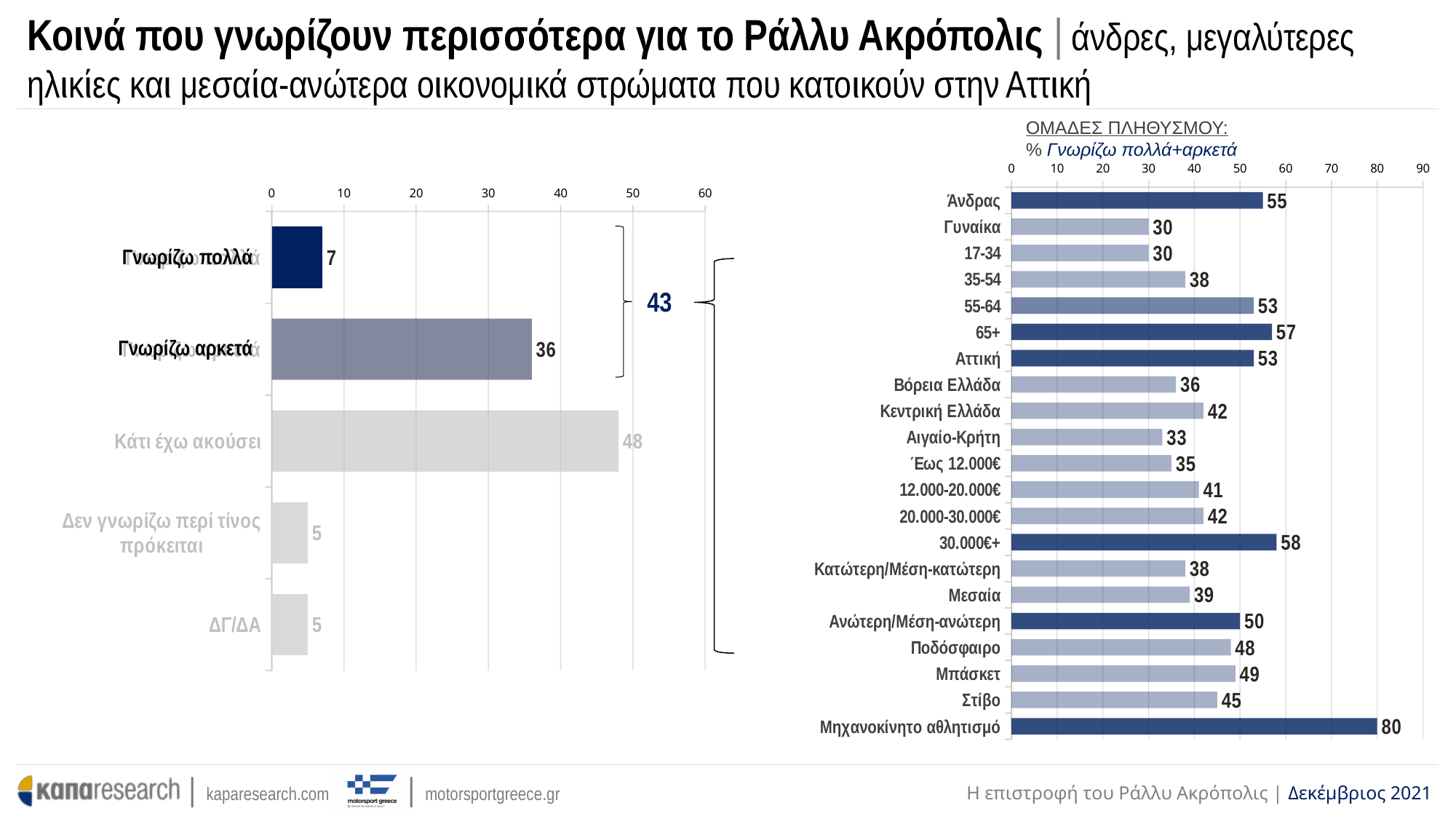
In the left chart, which category has the highest value? Κάτι έχω ακούσει In the left chart, what is the value for Κάτι έχω ακούσει? 48 In the right chart (ΟΜΑΔΕΣ ΠΛΗΘΥΣΜΟΥ), what is the value for Μηχανοκίνητο αθλητισμό? 80 In the left chart, what is the difference between Γνωρίζω αρκετά and Γνωρίζω πολλά? 29 In the right chart (ΟΜΑΔΕΣ ΠΛΗΘΥΣΜΟΥ), what is the difference between Άνδρας and Γυναίκα? 25 What type of chart is the right chart (ΟΜΑΔΕΣ ΠΛΗΘΥΣΜΟΥ)? Bar chart In the right chart (ΟΜΑΔΕΣ ΠΛΗΘΥΣΜΟΥ), which is larger, 30.000€+ or Έως 12.000€? 30.000€+ In the right chart (ΟΜΑΔΕΣ ΠΛΗΘΥΣΜΟΥ), how many categories are shown? 21 In the left chart, how many categories are shown? 5 In the right chart (ΟΜΑΔΕΣ ΠΛΗΘΥΣΜΟΥ), which category has the highest value? Μηχανοκίνητο αθλητισμό In the left chart, what combined value is shown by the bracket for Γνωρίζω πολλά and Γνωρίζω αρκετά? 43 In the right chart (ΟΜΑΔΕΣ ΠΛΗΘΥΣΜΟΥ), what is the value for Άνδρας? 55